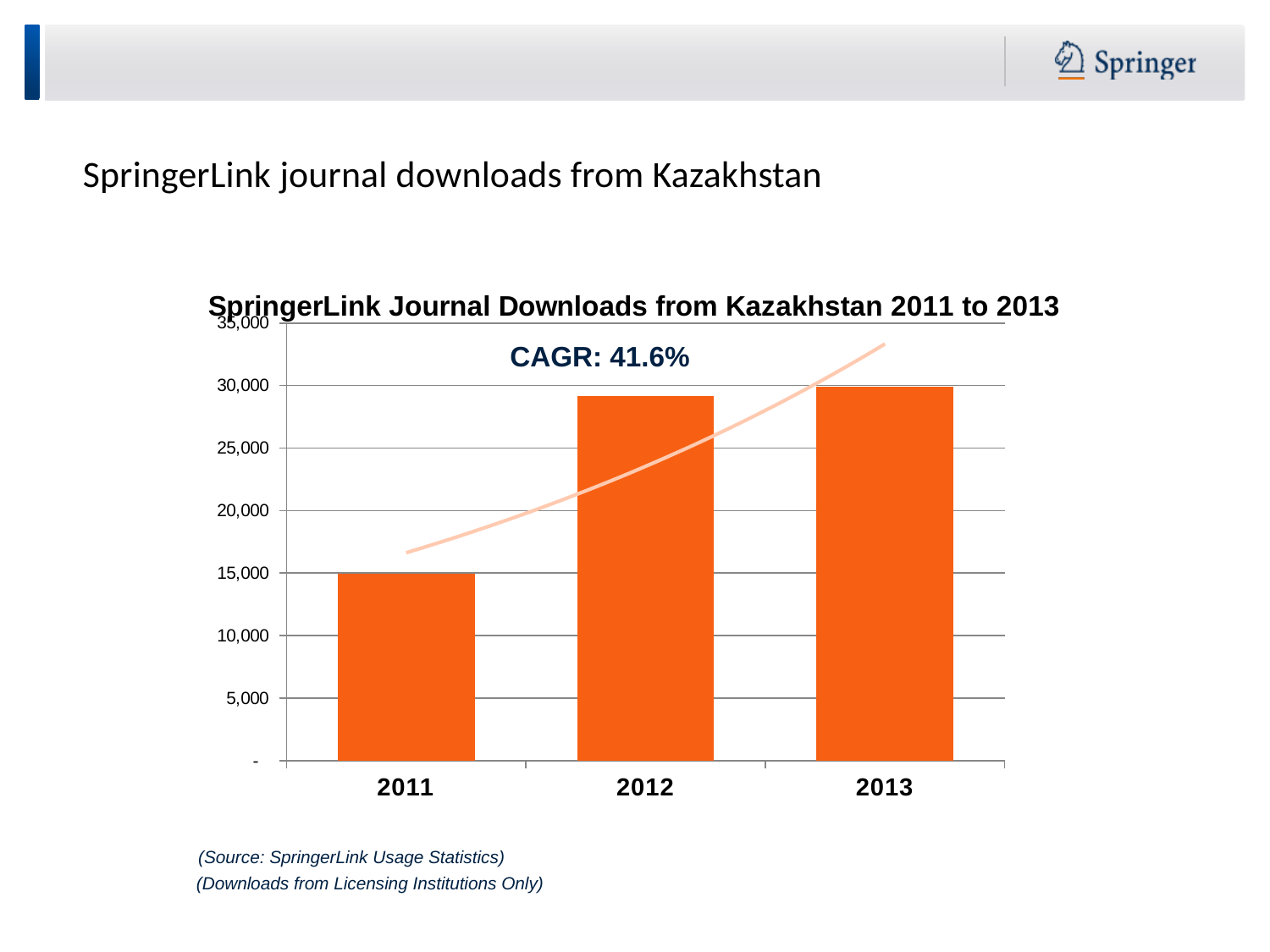
What kind of chart is shown on the slide? bar chart Is the value for 2011 greater or less than 10,000? greater Do the downloads rise or fall from 2011 to 2013? rise Is the value for 2013 greater or less than 25,000? greater Is the value for 2011 greater or less than 20,000? less How many years are plotted on the x axis of the chart? 3 What CAGR is stated on the chart? 41.6% What is the title of the chart? SpringerLink Journal Downloads from Kazakhstan 2011 to 2013 Which year has the highest number of SpringerLink journal downloads from Kazakhstan? 2013 Which year has the lowest number of SpringerLink journal downloads from Kazakhstan? 2011 Which year has more downloads, 2011 or 2012? 2012